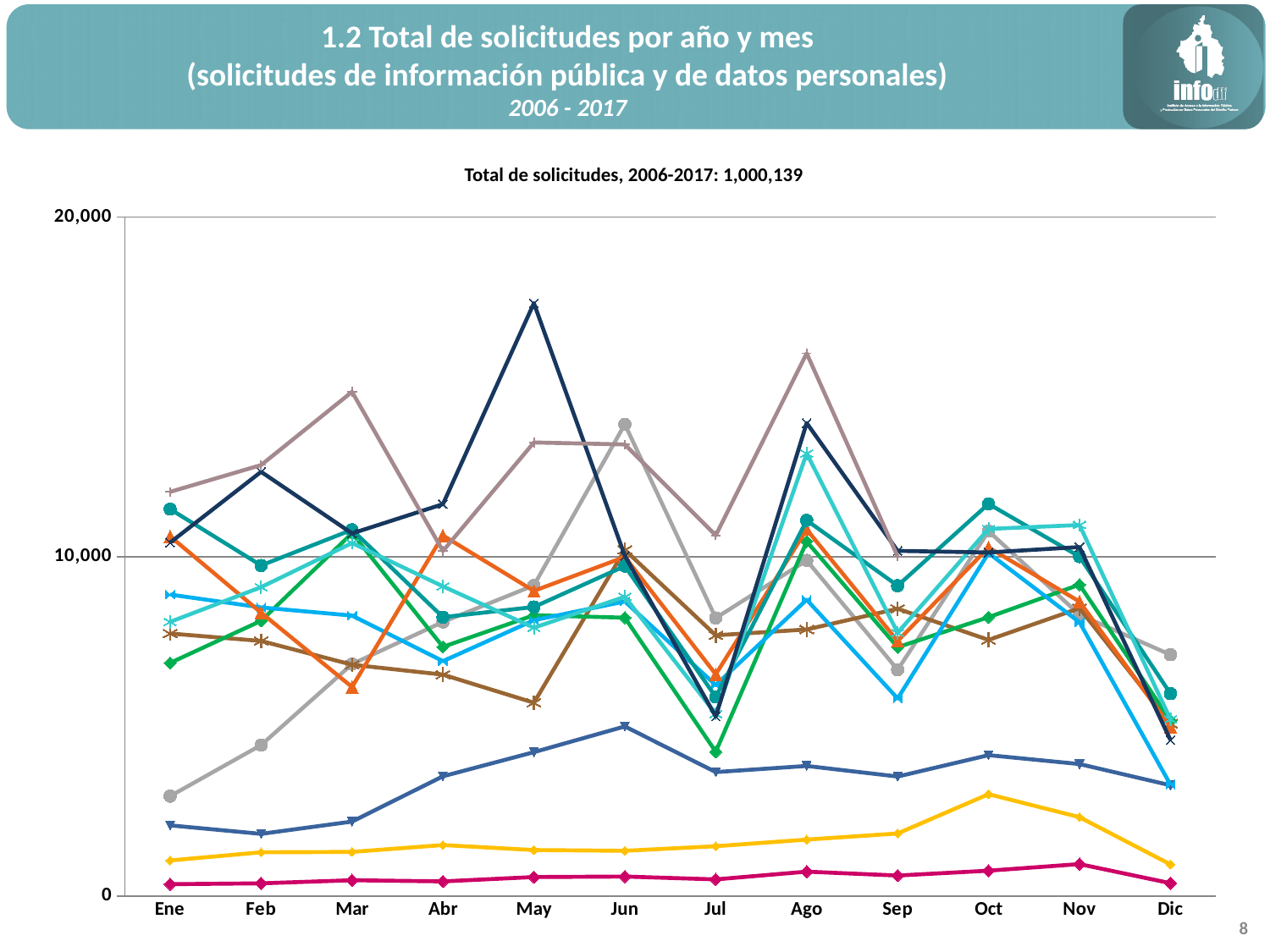
Is the highest value plotted in Ago greater or less than 10,000? greater Is the highest value plotted in May greater or less than 10,000? greater How many months are shown on the x axis of the chart? 12 Which month has the larger highest plotted value, May or Jun? May Does the highest plotted value per month rise or fall from Oct to Dic? fall Is the lowest value plotted in Oct greater or less than 10,000? less In which month does the chart reach its single highest plotted point? May According to the chart title, what is the total number of solicitudes for 2006-2017? 1,000,139 What kind of chart is shown on the slide? line chart What is the title printed above the chart? Total de solicitudes, 2006-2017: 1,000,139